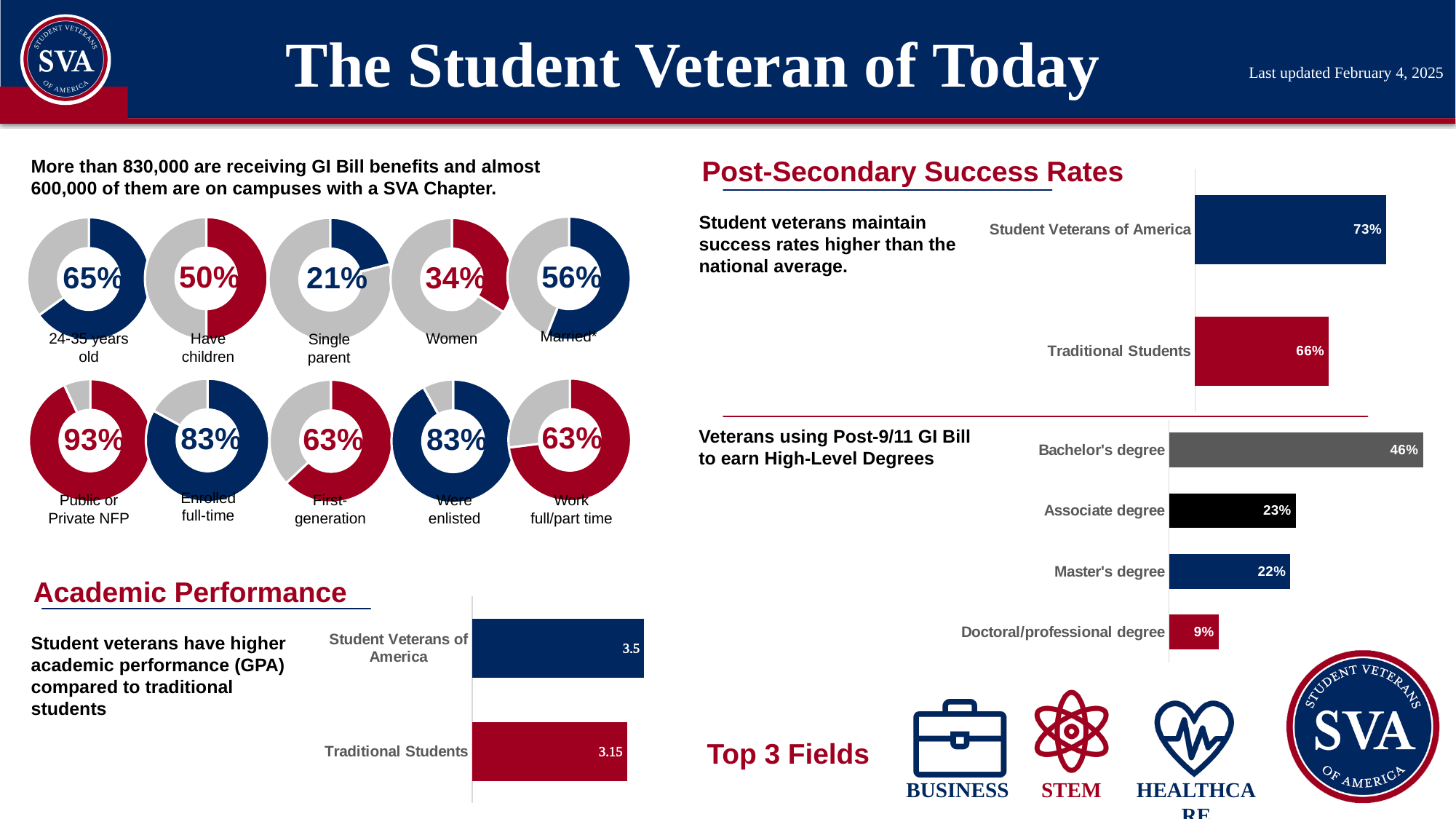
In the Veterans using Post-9/11 GI Bill to earn High-Level Degrees chart, what is the value for Associate degree? 23% In the Post-Secondary Success Rates chart, what is the difference between the Student Veterans of America rate and the Traditional Students rate? 7% In the donut charts at the top left, what percentage of student veterans attend a Public or Private NFP institution? 93% In the Post-Secondary Success Rates chart, what is the success rate for Student Veterans of America? 73% In the Veterans using Post-9/11 GI Bill to earn High-Level Degrees chart, which degree has the lowest value? Doctoral/professional degree How many degree categories are shown in the Veterans using Post-9/11 GI Bill to earn High-Level Degrees chart? 4 In the Veterans using Post-9/11 GI Bill to earn High-Level Degrees chart, which degree has the highest value? Bachelor's degree In the Academic Performance chart, which group has the higher GPA, Student Veterans of America or Traditional Students? Student Veterans of America In the Post-Secondary Success Rates chart, what is the success rate for Traditional Students? 66% In the donut charts at the top left, what percentage of student veterans are Women? 34% What kind of chart is the Academic Performance chart? Bar chart In the Academic Performance chart, what is the GPA for Student Veterans of America? 3.5